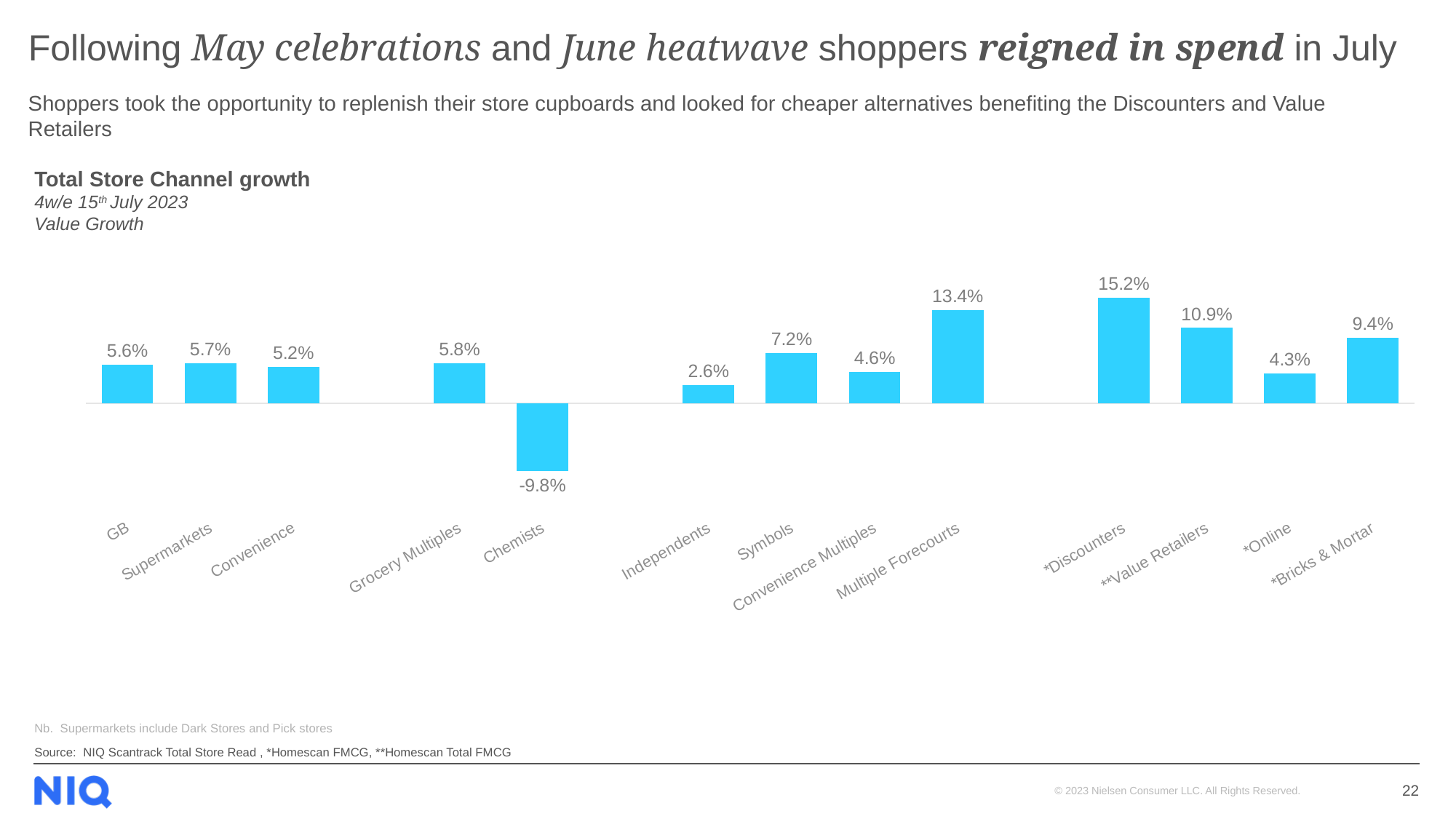
What period does the chart cover? 4w/e 15th July 2023 Which has higher value growth, Symbols or Convenience Multiples? Symbols What is the value growth for Chemists? -9.8% What is the value growth for Discounters? 15.2% What is the difference in value growth between Discounters and Value Retailers? 4.3 percentage points What type of chart is used to show Total Store Channel growth? Bar chart What is the difference in value growth between Grocery Multiples and GB? 0.2 percentage points What is the value growth for Multiple Forecourts? 13.4% How many channels are shown in the chart? 14 Which channel has the lowest value growth? Chemists Which channel has the highest value growth? Discounters What is the value growth for Independents? 2.6%